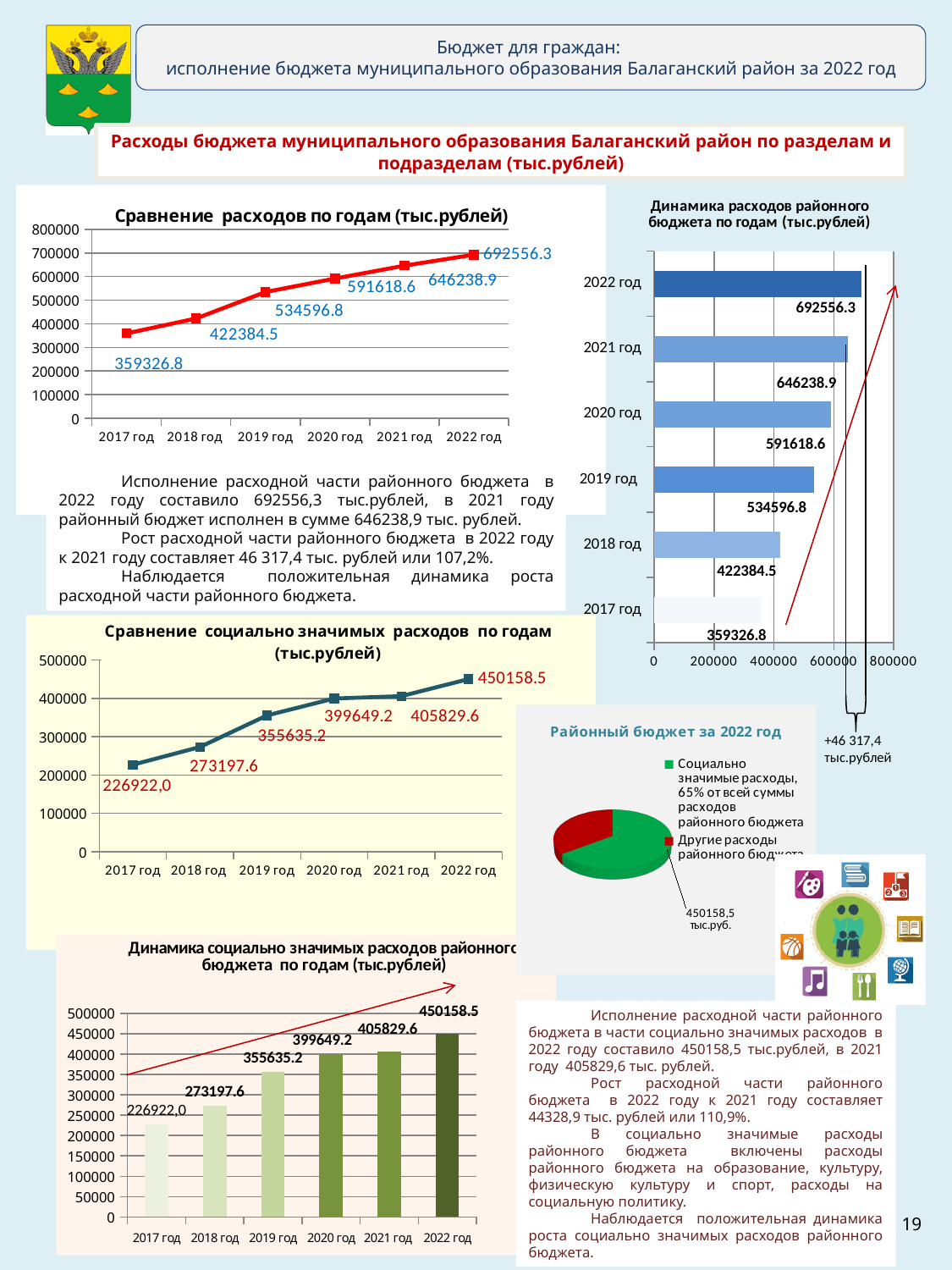
In the chart 'Сравнение социально значимых расходов по годам (тыс.рублей)', what is the value for 2020 год? 399649.2 In the chart 'Сравнение социально значимых расходов по годам (тыс.рублей)', which year has the lowest value? 2017 год In the chart 'Сравнение расходов по годам (тыс.рублей)', which year has the highest value? 2022 год In the chart 'Динамика социально значимых расходов районного бюджета по годам (тыс.рублей)', which is larger, the value for 2019 год or 2018 год? 2019 год In the chart 'Динамика расходов районного бюджета по годам (тыс.рублей)', what is the difference between the values for 2022 год and 2021 год? 46317.4 What kind of chart is 'Динамика расходов районного бюджета по годам (тыс.рублей)'? bar chart In the chart 'Динамика расходов районного бюджета по годам (тыс.рублей)', what is the value for 2018 год? 422384.5 In the pie chart 'Районный бюджет за 2022 год', what share of total expenditures do socially significant expenditures (Социально значимые расходы) make up? 65% In the chart 'Сравнение расходов по годам (тыс.рублей)', what is the value for 2019 год? 534596.8 In the chart 'Сравнение расходов по годам (тыс.рублей)', do the values rise or fall from 2017 год to 2022 год? rise In the chart 'Динамика социально значимых расходов районного бюджета по годам (тыс.рублей)', what is the value for 2021 год? 405829.6 How many years are plotted in the chart 'Сравнение социально значимых расходов по годам (тыс.рублей)'? 6